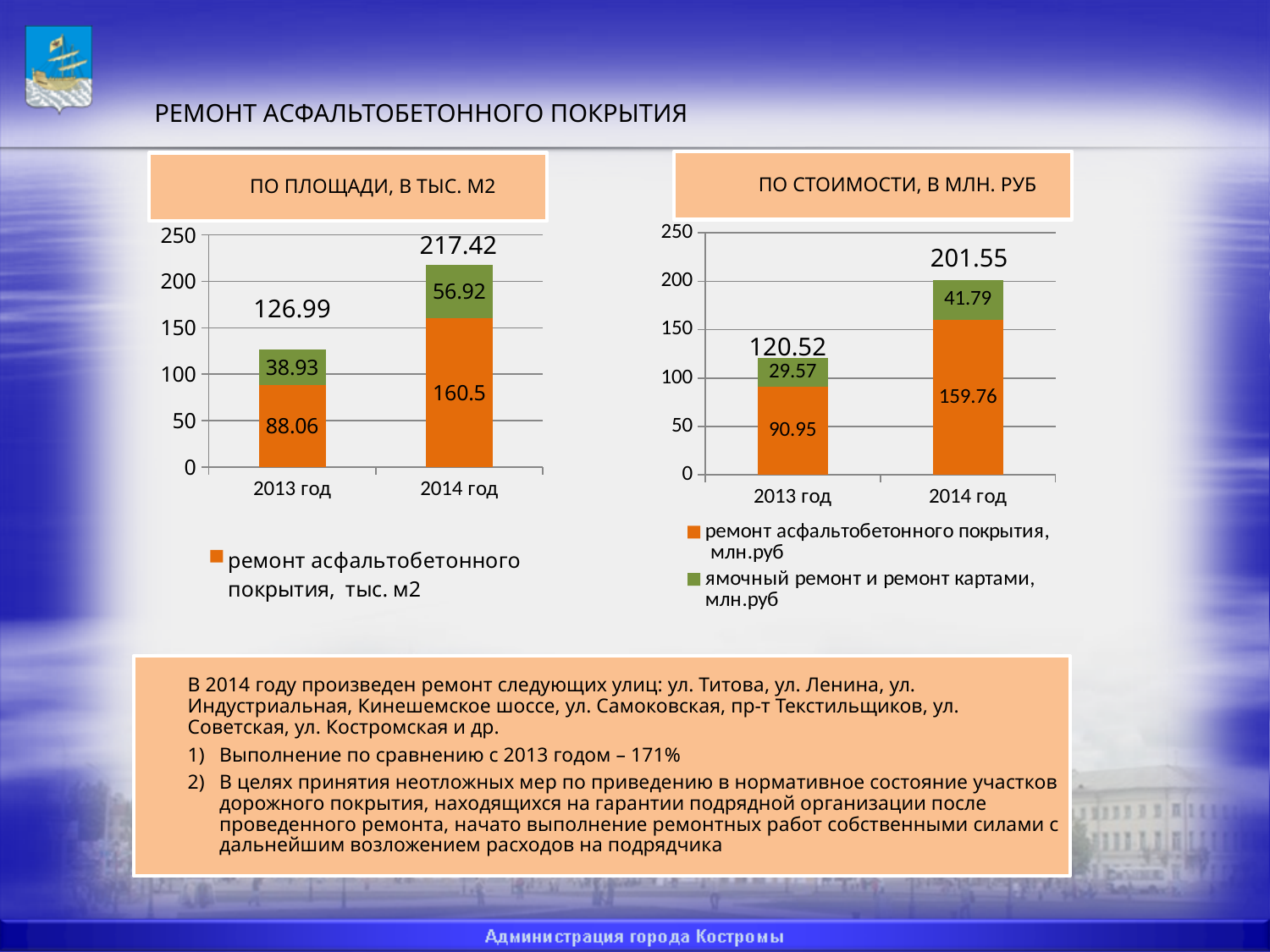
In the chart titled "ПО СТОИМОСТИ, В МЛН. РУБ", what is the value of ремонт асфальтобетонного покрытия for 2014 год? 159.76 In the chart titled "ПО ПЛОЩАДИ, В ТЫС. М2", how many categories are shown on the x axis? 2 In the chart titled "ПО СТОИМОСТИ, В МЛН. РУБ", how many series does the legend list? 2 What kind of chart is the chart titled "ПО СТОИМОСТИ, В МЛН. РУБ"? Stacked bar chart In the chart titled "ПО ПЛОЩАДИ, В ТЫС. М2", what is the total of the stacked bar for 2014 год? 217.42 In the chart titled "ПО ПЛОЩАДИ, В ТЫС. М2", what is the difference between the stacked totals for 2014 год and 2013 год? 90.43 In the chart titled "ПО ПЛОЩАДИ, В ТЫС. М2", what is the value of the green segment for 2014 год? 56.92 In the chart titled "ПО СТОИМОСТИ, В МЛН. РУБ", what is the value of ямочный ремонт и ремонт картами for 2013 год? 29.57 In the chart titled "ПО СТОИМОСТИ, В МЛН. РУБ", which year has the higher stacked total? 2014 год In the chart titled "ПО СТОИМОСТИ, В МЛН. РУБ", is the stacked total for 2014 год greater or less than 200? greater In the chart titled "ПО СТОИМОСТИ, В МЛН. РУБ", what is the total of the stacked bar for 2013 год? 120.52 In the chart titled "ПО ПЛОЩАДИ, В ТЫС. М2", what is the value of the orange segment (ремонт асфальтобетонного покрытия) for 2013 год? 88.06